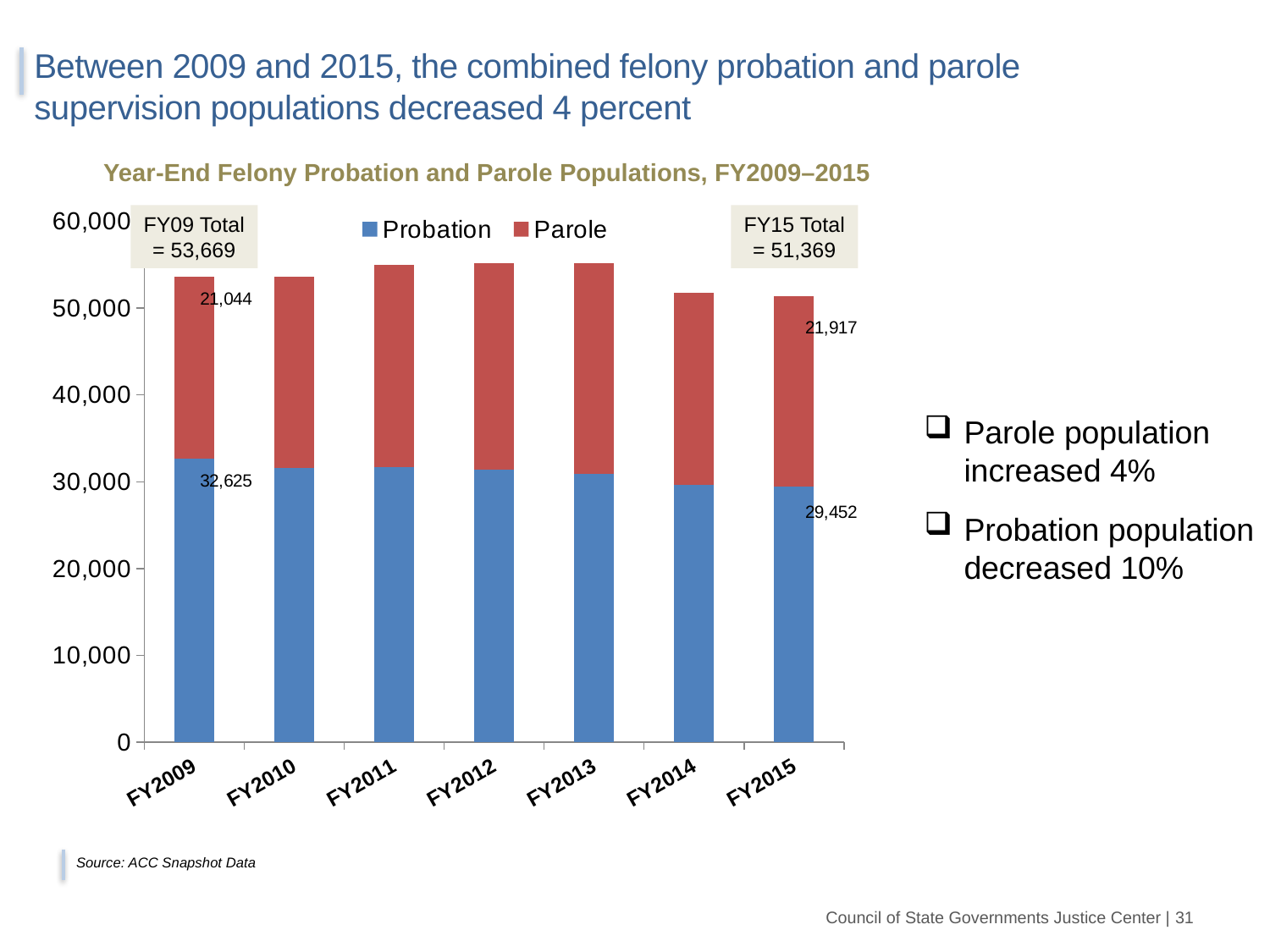
What is the Parole value for FY2015? 21,917 Which is larger, the Probation value for FY2009 or the Probation value for FY2015? FY2009 What is the Probation value for FY2009? 32,625 How many fiscal years are shown on the x axis? 7 What is the total of the stacked bar for FY2009? 53,669 How many series does the legend list? 2 What is the Parole value for FY2009? 21,044 What is the Probation value for FY2015? 29,452 What is the total of the stacked bar for FY2015? 51,369 By how much did the Probation value decrease from FY2009 to FY2015? 3,173 What kind of chart is shown on the slide? Stacked bar chart Is the total for FY2014 greater or less than 50,000? greater